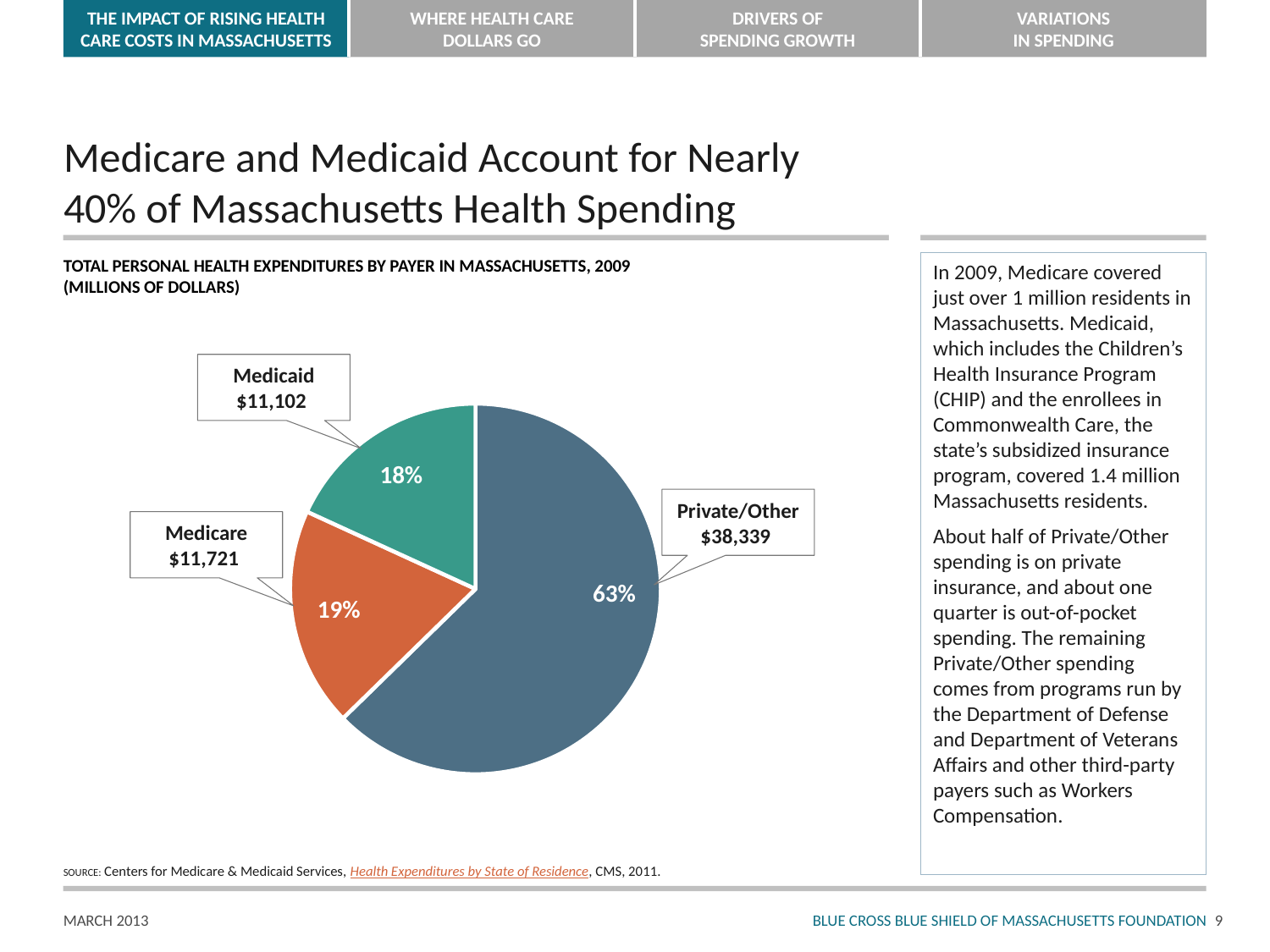
Which payer accounts for the largest share of spending? Private/Other What is the value for Medicare? $11,721 What is the title of the chart? Total Personal Health Expenditures by Payer in Massachusetts, 2009 (Millions of Dollars) What share of the pie does Medicare represent? 19% How many payer categories are shown in the pie chart? 3 Which payer accounts for the smallest share of spending? Medicaid What type of chart is shown on the slide? Pie chart What is the value for Medicaid? $11,102 What is the value for Private/Other? $38,339 What share of the pie does Private/Other represent? 63% What is the difference between the Private/Other value and the Medicare value? $26,618 What share of the pie does Medicaid represent? 18%